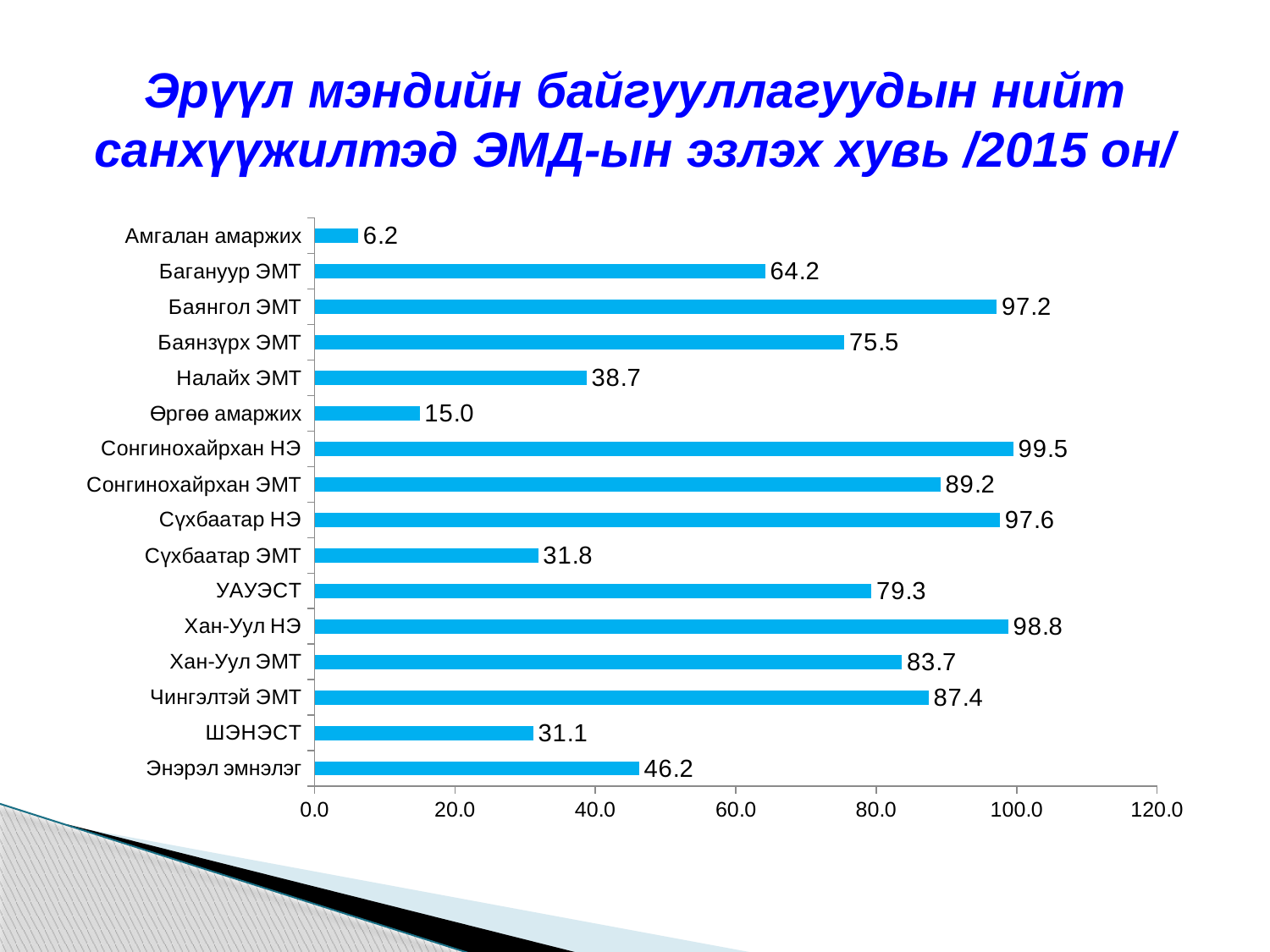
Which category has the highest value? Сонгинохайрхан НЭ Which is larger, the value for Багануур ЭМТ or the value for Энэрэл эмнэлэг? Багануур ЭМТ What is the value for Энэрэл эмнэлэг? 46.2 What is the value for Чингэлтэй ЭМТ? 87.4 What is the value for Налайх ЭМТ? 38.7 How many categories are shown in the chart? 16 Which category has the lowest value? Амгалан амаржих What is the highest value shown on the x axis? 120.0 What kind of chart is shown on the slide? bar chart What is the difference between the values for Сүхбаатар НЭ and Сүхбаатар ЭМТ? 65.8 What is the value for Баянгол ЭМТ? 97.2 Is the value for Хан-Уул ЭМТ greater or less than 80.0? greater